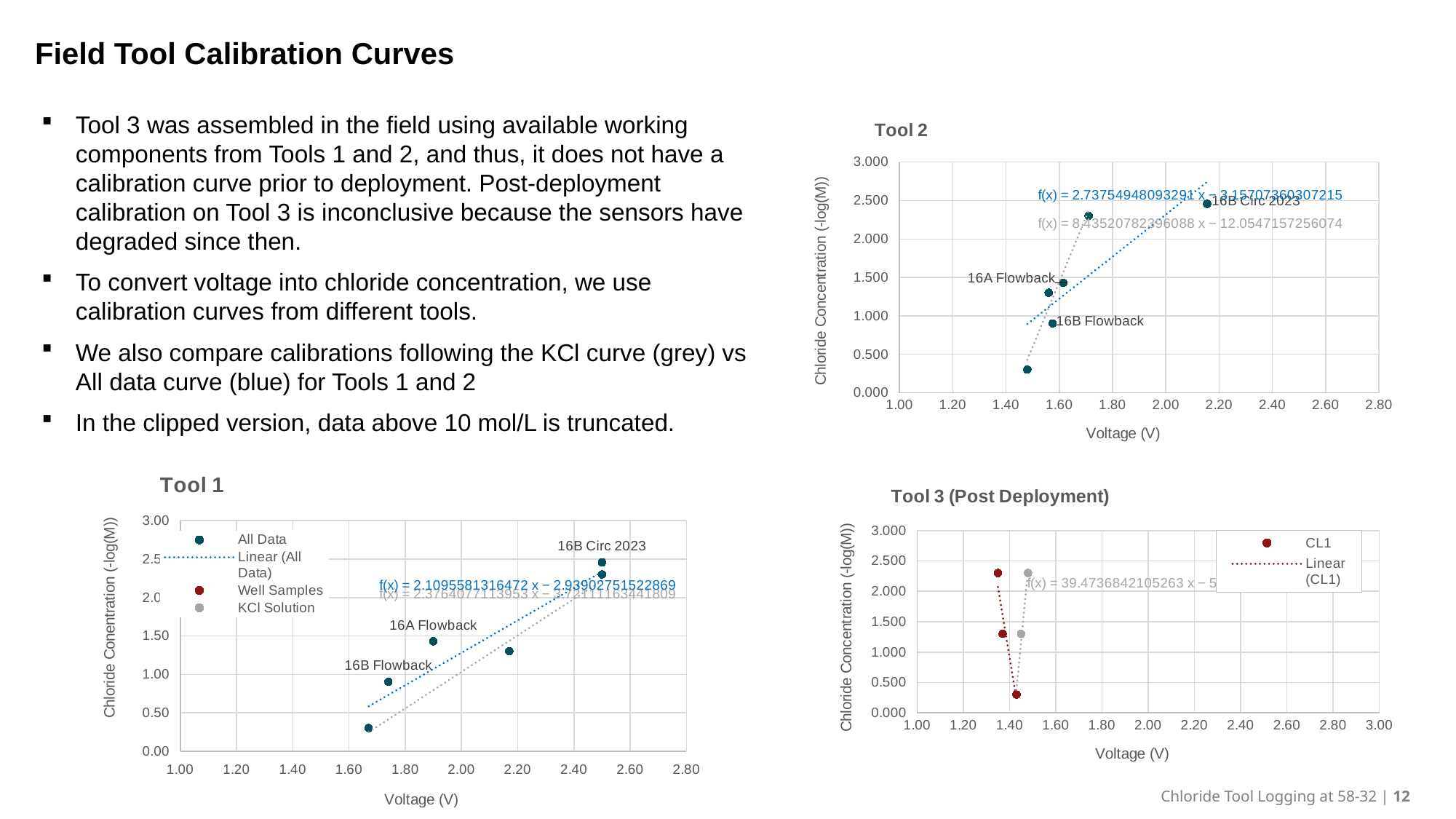
What is the x-axis label of the Tool 2 chart? Voltage (V) In the Tool 1 chart, which has the higher chloride concentration, 16A Flowback or 16B Flowback? 16A Flowback What kind of chart is the Tool 1 chart? scatter chart How many entries does the legend of the Tool 3 (Post Deployment) chart list? 2 How many entries does the legend of the Tool 1 chart list? 4 In the Tool 2 chart, is the value for 16B Flowback greater or less than 1.000? less In the Tool 2 chart, which labeled point has the highest chloride concentration? 16B Circ 2023 In the Tool 2 chart, is the value for 16A Flowback greater or less than 1.000? greater In the Tool 1 chart, is the value for 16B Circ 2023 greater or less than 2.00? greater In the Tool 2 chart, what is the slope in the blue trendline equation f(x)? 2.73754948093291 What is the title of the chart at the bottom right of the slide? Tool 3 (Post Deployment)